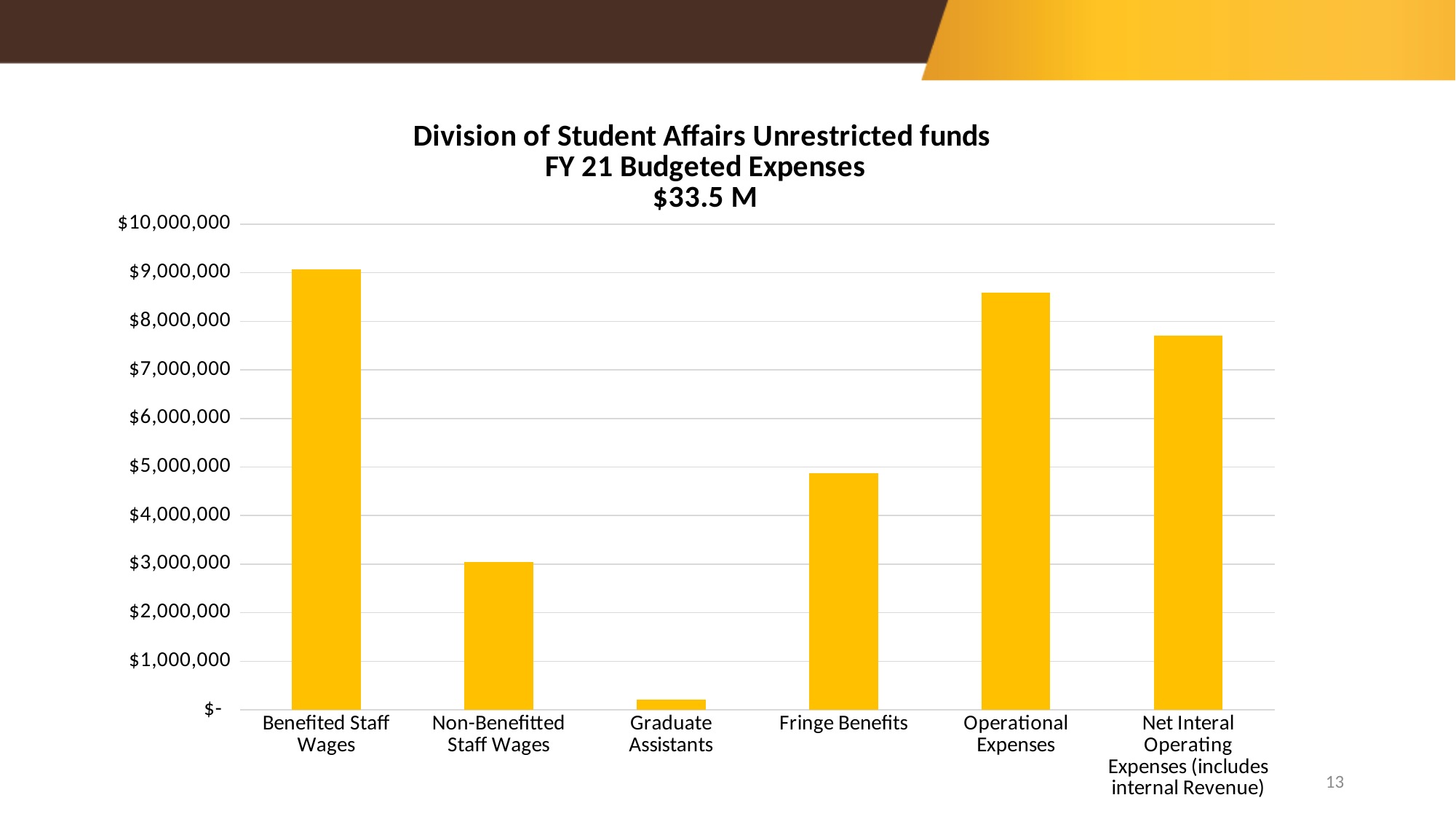
What total amount is stated in the chart title? $33.5 M Which is larger, the value for Fringe Benefits or the value for Non-Benefitted Staff Wages? Fringe Benefits What kind of chart is shown on the slide? Bar chart Is the value for Graduate Assistants greater or less than $1,000,000? less Which category has the highest budgeted expense? Benefited Staff Wages What is the highest value shown on the vertical axis? $10,000,000 Which is larger, the value for Operational Expenses or the value for Net Interal Operating Expenses (includes internal Revenue)? Operational Expenses Is the value for Benefited Staff Wages greater or less than $8,000,000? greater Is the value for Non-Benefitted Staff Wages greater or less than $4,000,000? less How many expense categories are plotted on the chart? 6 Which category has the lowest budgeted expense? Graduate Assistants